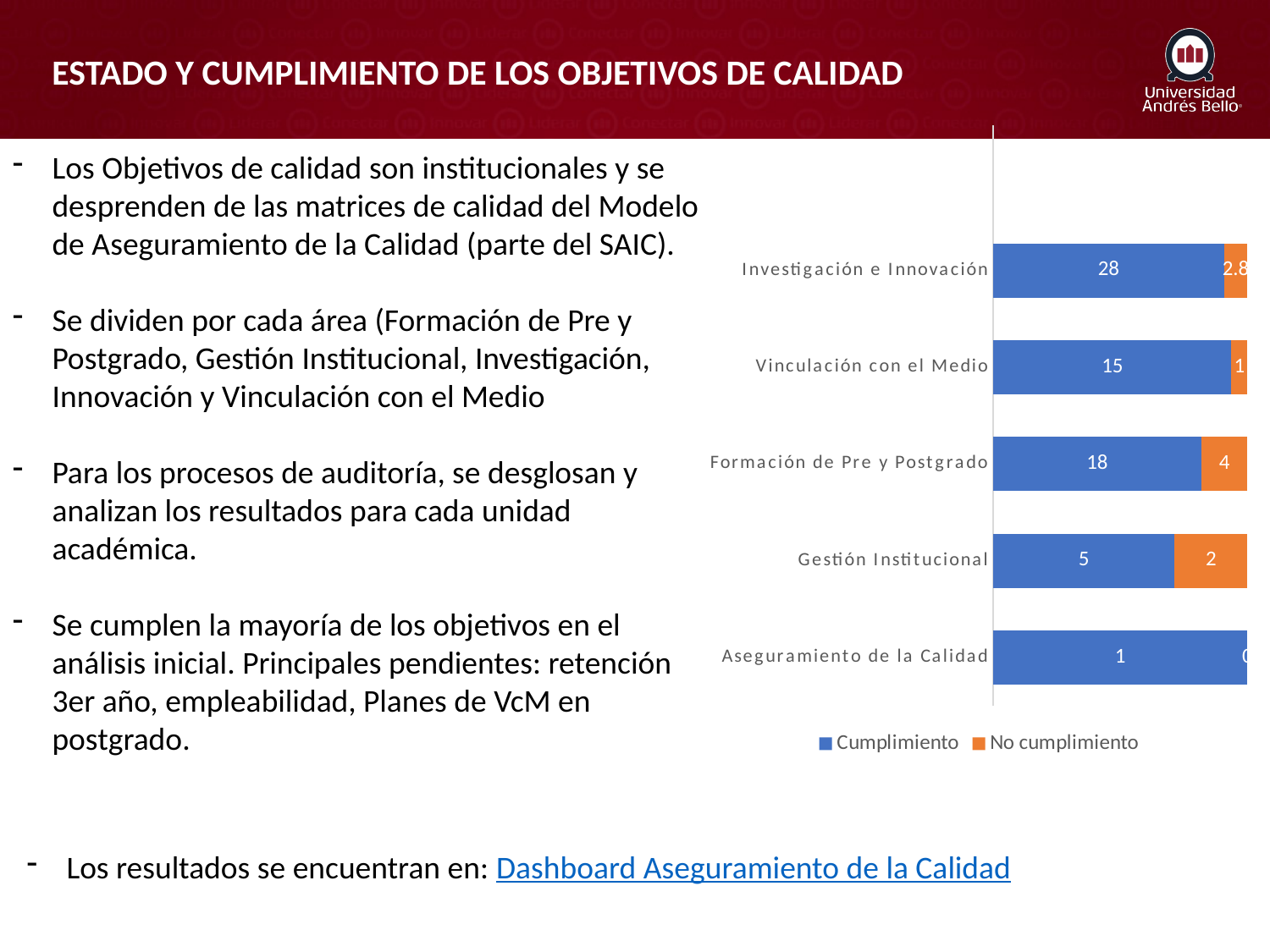
What is the difference between the Cumplimiento values for Investigación e Innovación and Formación de Pre y Postgrado? 10 What is the No cumplimiento value for Formación de Pre y Postgrado? 4 Which category has the lowest Cumplimiento value? Aseguramiento de la Calidad How many categories are shown in the chart? 5 What is the Cumplimiento value for Investigación e Innovación? 28 What kind of chart is shown on the slide? Stacked bar chart Which has a larger Cumplimiento value, Vinculación con el Medio or Gestión Institucional? Vinculación con el Medio What is the Cumplimiento value for Formación de Pre y Postgrado? 18 Which category has the highest Cumplimiento value? Investigación e Innovación How many series does the legend list? 2 What is the No cumplimiento value for Gestión Institucional? 2 What is the total of the stacked bar for Formación de Pre y Postgrado? 22